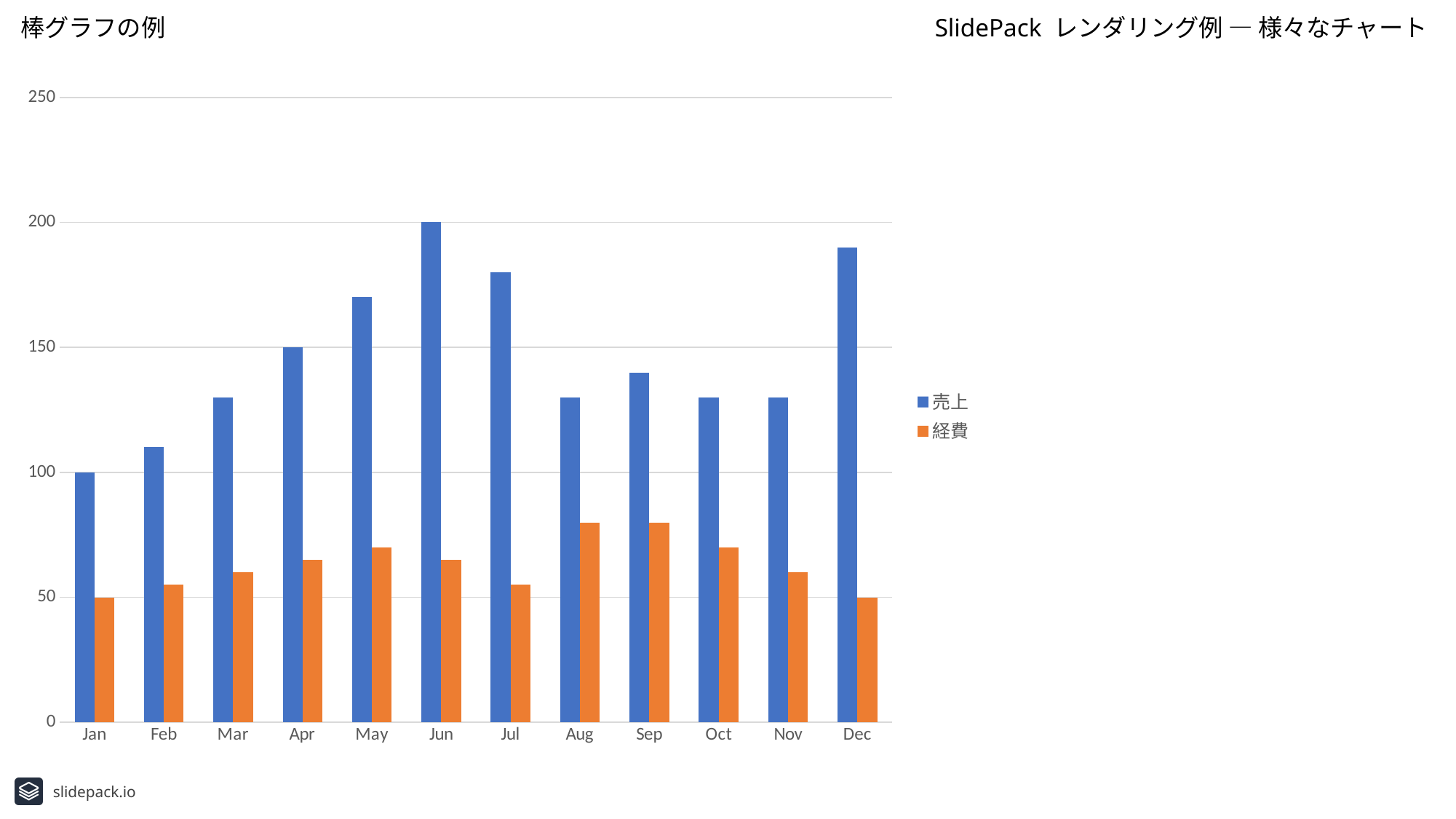
Which is larger, the 売上 value for Jul or the 売上 value for Sep? Jul Which month has the lowest 売上 value? Jan Is the 経費 value for Aug greater or less than 100? less How many months are shown on the x axis? 12 How many series does the legend list? 2 Which month has the highest 売上 value? Jun What is the 売上 value for Jun? 200 What is the title of the chart? 棒グラフの例 What kind of chart is shown on the slide? bar chart What is the 売上 value for Jan? 100 What is the 売上 value for Apr? 150 Is the 売上 value for Dec greater or less than 150? greater